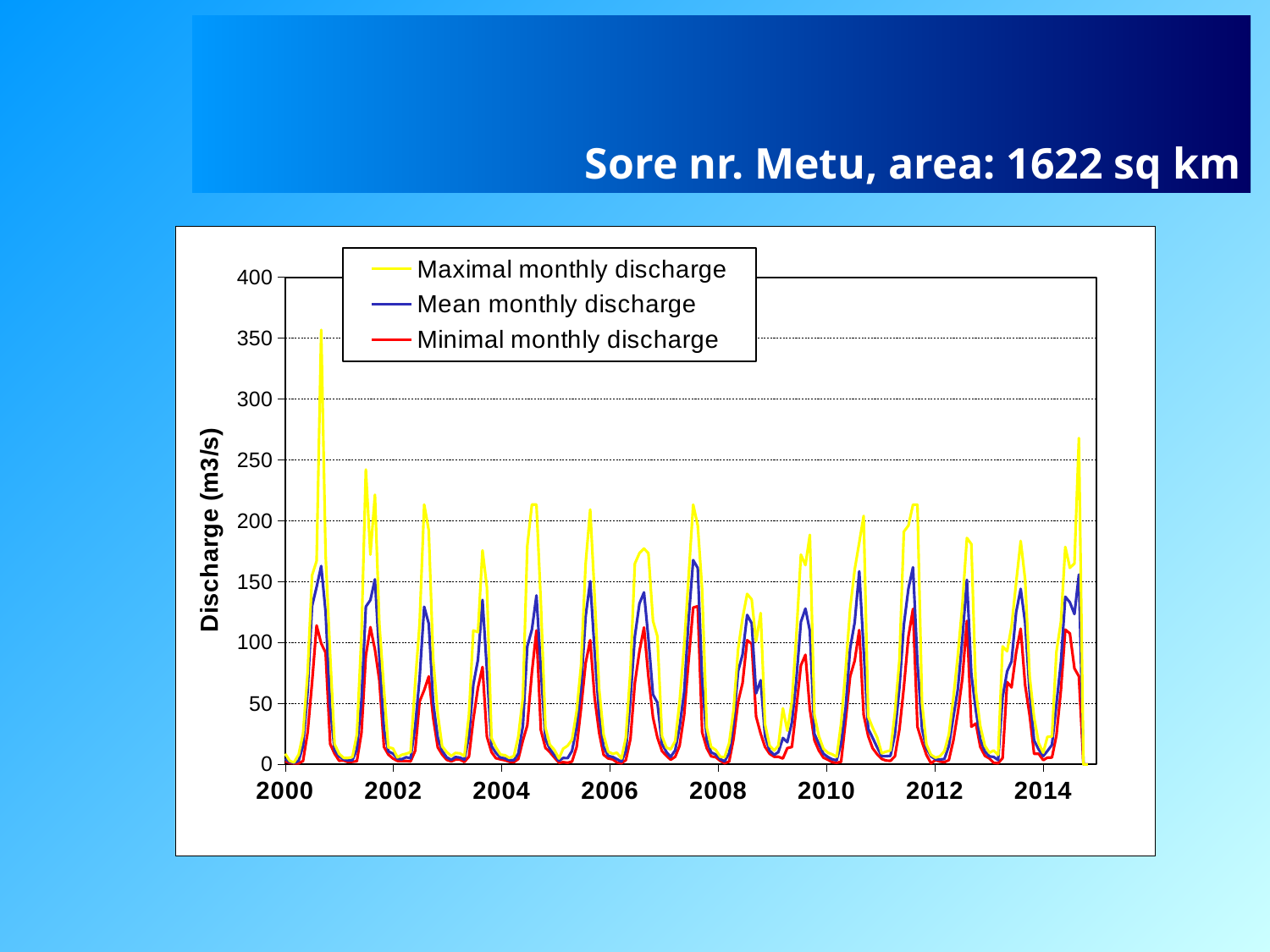
Is the highest peak of the Mean monthly discharge series greater or less than 200? less Is the highest peak of the Maximal monthly discharge series greater or less than 300? greater Which is larger at the 2000 peak: the Maximal monthly discharge or the Mean monthly discharge? Maximal monthly discharge Which series stays lowest throughout the chart? Minimal monthly discharge Is the highest peak of the Minimal monthly discharge series greater or less than 150? less How many series does the legend list? 3 In which year does the Maximal monthly discharge series reach its highest peak? 2000 What kind of chart is shown on the slide? Line chart Which series reaches the highest value on the chart? Maximal monthly discharge What is the label of the vertical axis? Discharge (m3/s) Which colour is used for the Minimal monthly discharge series? Red